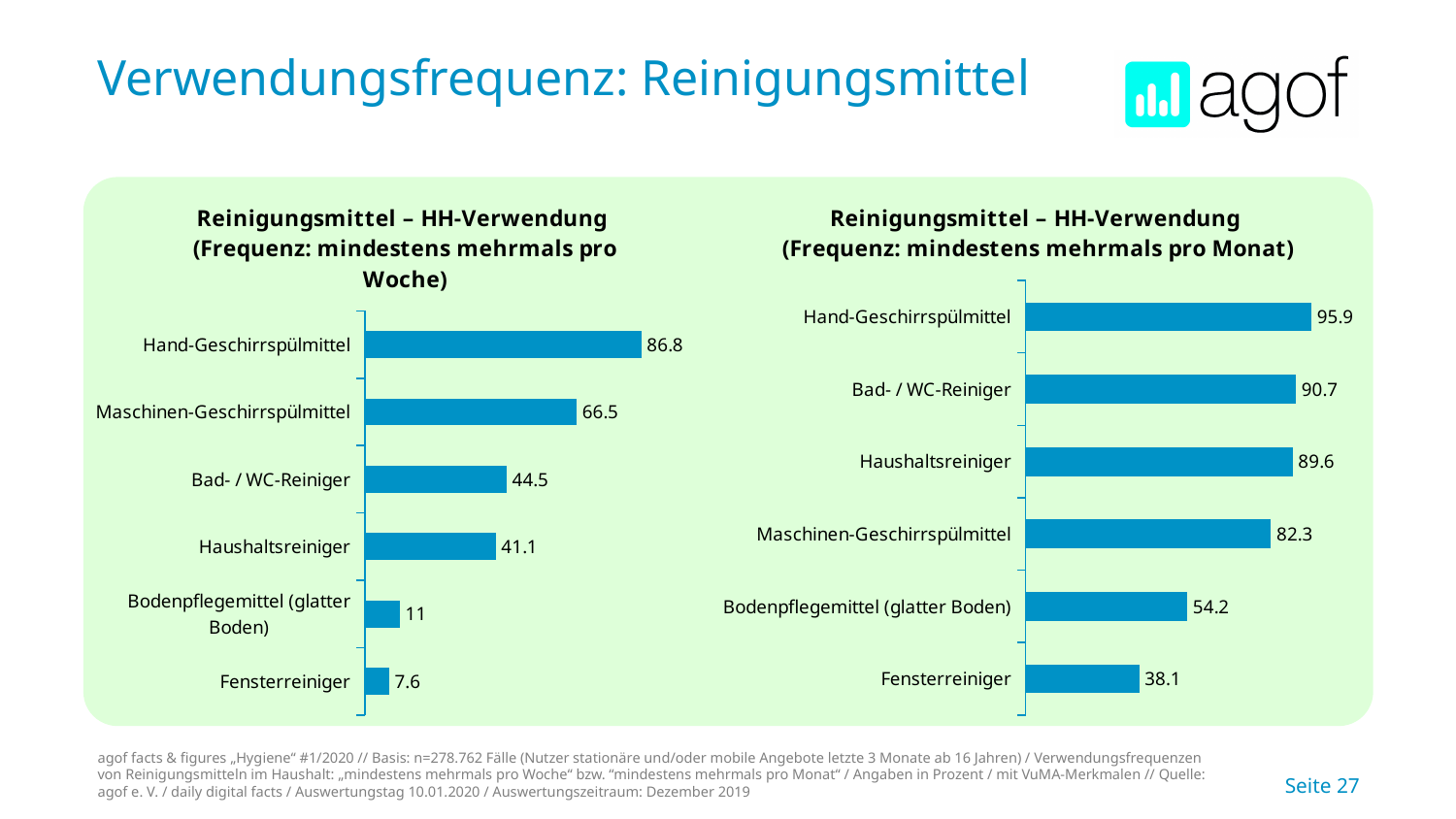
What kind of chart is the right chart (mindestens mehrmals pro Monat)? Bar chart In the right chart (mindestens mehrmals pro Monat), which category has the highest value? Hand-Geschirrspülmittel In the right chart (mindestens mehrmals pro Monat), which is larger: Maschinen-Geschirrspülmittel or Haushaltsreiniger? Haushaltsreiniger In the right chart (mindestens mehrmals pro Monat), what is the value for Bad- / WC-Reiniger? 90.7 What is the title of the right chart? Reinigungsmittel – HH-Verwendung (Frequenz: mindestens mehrmals pro Monat) In the right chart (mindestens mehrmals pro Monat), what is the difference between Bodenpflegemittel (glatter Boden) and Fensterreiniger? 16.1 How many categories are shown in the left chart (mindestens mehrmals pro Woche)? 6 In the left chart (mindestens mehrmals pro Woche), which is larger: Bad- / WC-Reiniger or Haushaltsreiniger? Bad- / WC-Reiniger In the left chart (mindestens mehrmals pro Woche), what is the difference between Hand-Geschirrspülmittel and Maschinen-Geschirrspülmittel? 20.3 In the left chart (mindestens mehrmals pro Woche), what is the value for Hand-Geschirrspülmittel? 86.8 In the left chart (mindestens mehrmals pro Woche), which category has the lowest value? Fensterreiniger In the left chart (mindestens mehrmals pro Woche), what is the value for Bodenpflegemittel (glatter Boden)? 11